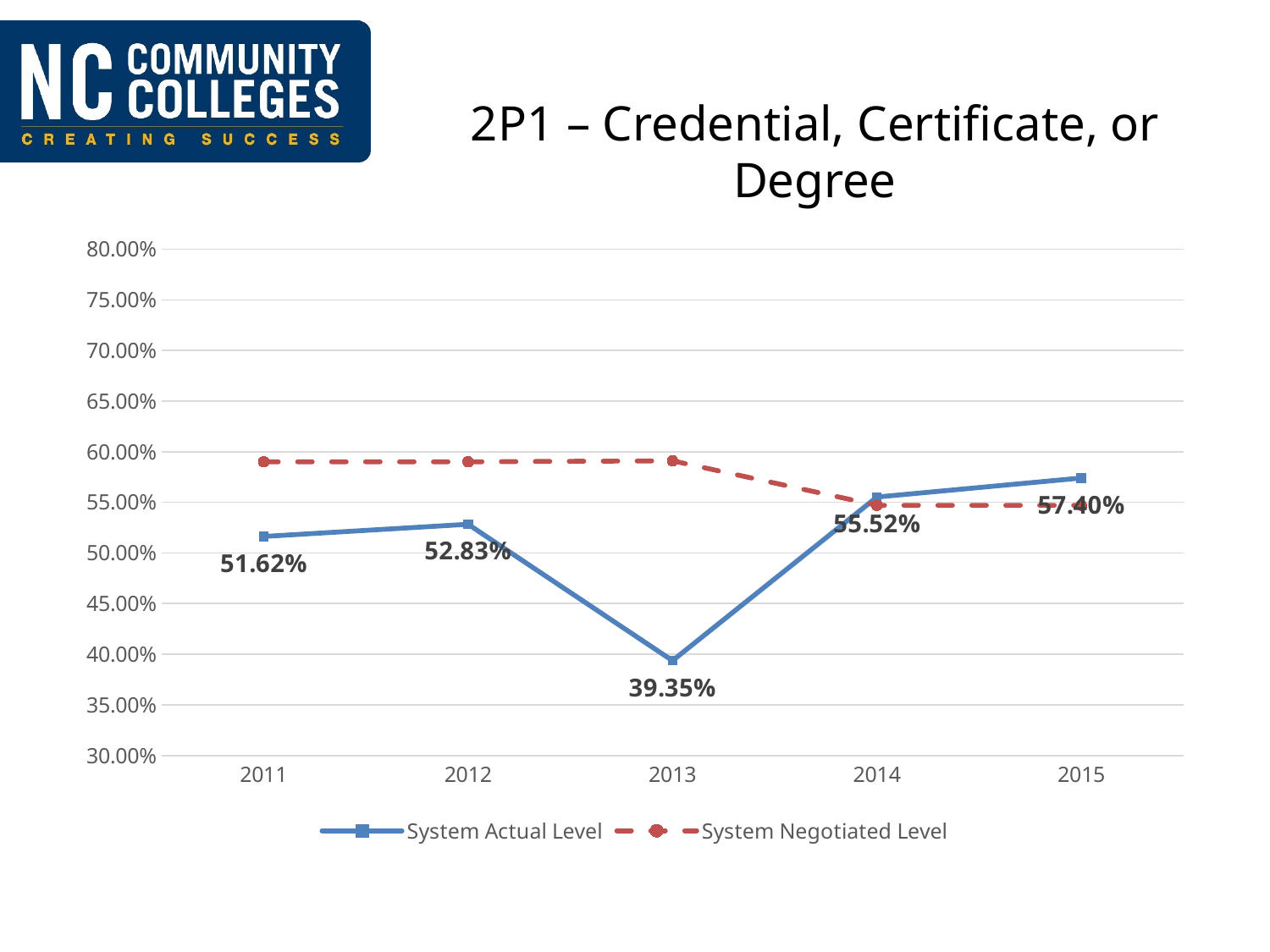
How many series does the legend list? 2 What is the difference between the System Actual Level in 2014 and in 2013? 16.17% In which year is the System Actual Level highest? 2015 What kind of chart is shown on the slide? Line chart Which is larger, the System Actual Level in 2012 or in 2014? 2014 What is the System Actual Level for 2015? 57.40% What is the System Actual Level for 2013? 39.35% Does the System Actual Level rise or fall from 2013 to 2015? Rise What is the System Actual Level for 2011? 51.62% In which year is the System Actual Level lowest? 2013 Is the System Negotiated Level for 2011 greater or less than 55.00%? greater How many years are shown on the x axis? 5